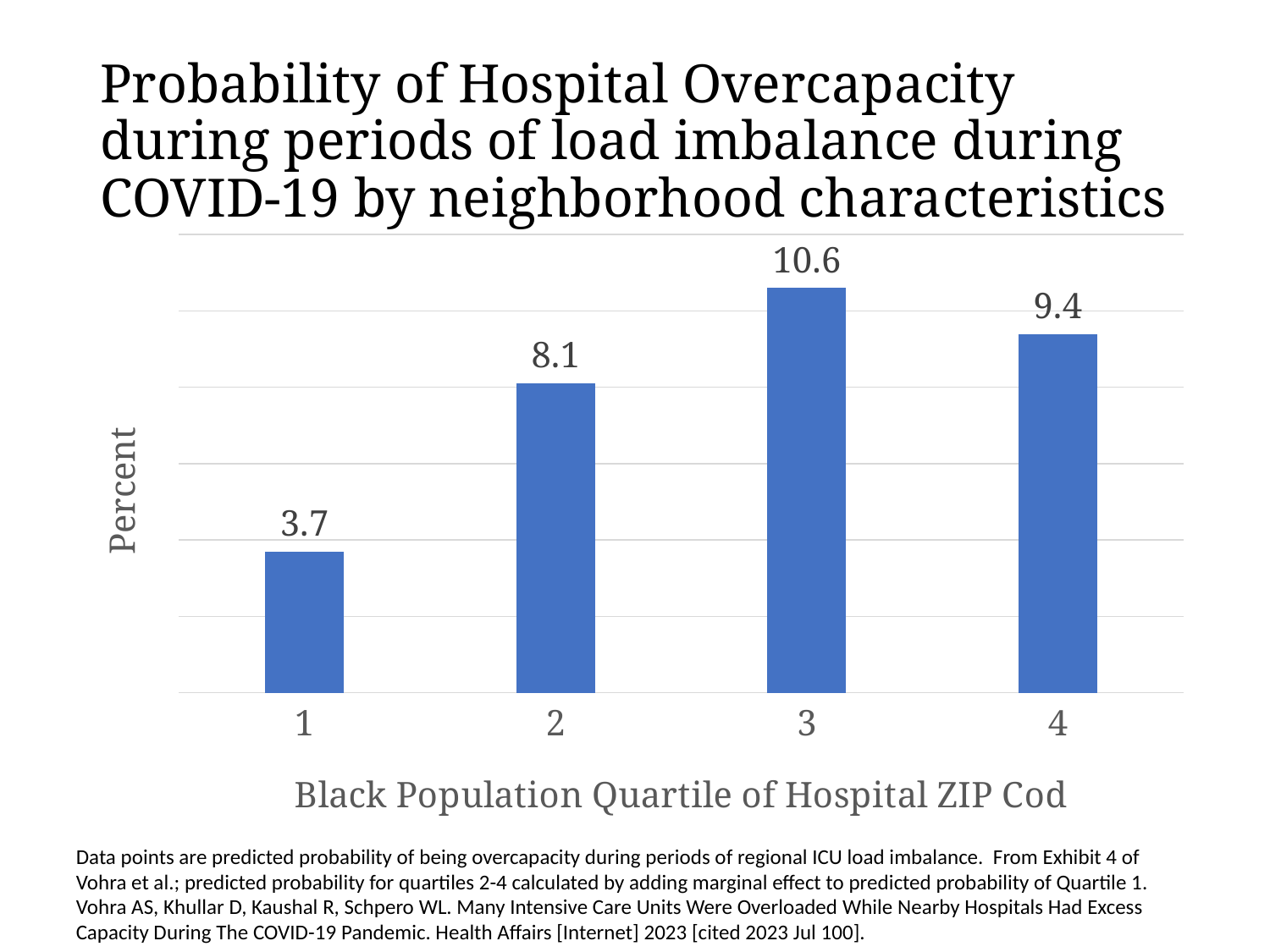
How many quartiles are shown on the x axis? 4 Which quartile has the highest value? 3 What is the value for quartile 1? 3.7 What kind of chart is this? bar chart What is the value for quartile 3? 10.6 What is the difference between the values for quartile 2 and quartile 4? 1.3 What is the difference between the values for quartile 3 and quartile 1? 6.9 What is the value for quartile 4? 9.4 What is the label of the x axis? Black Population Quartile of Hospital ZIP Cod What is the label of the y axis? Percent Which is larger, the value for quartile 2 or quartile 4? quartile 4 Which quartile has the lowest value? 1